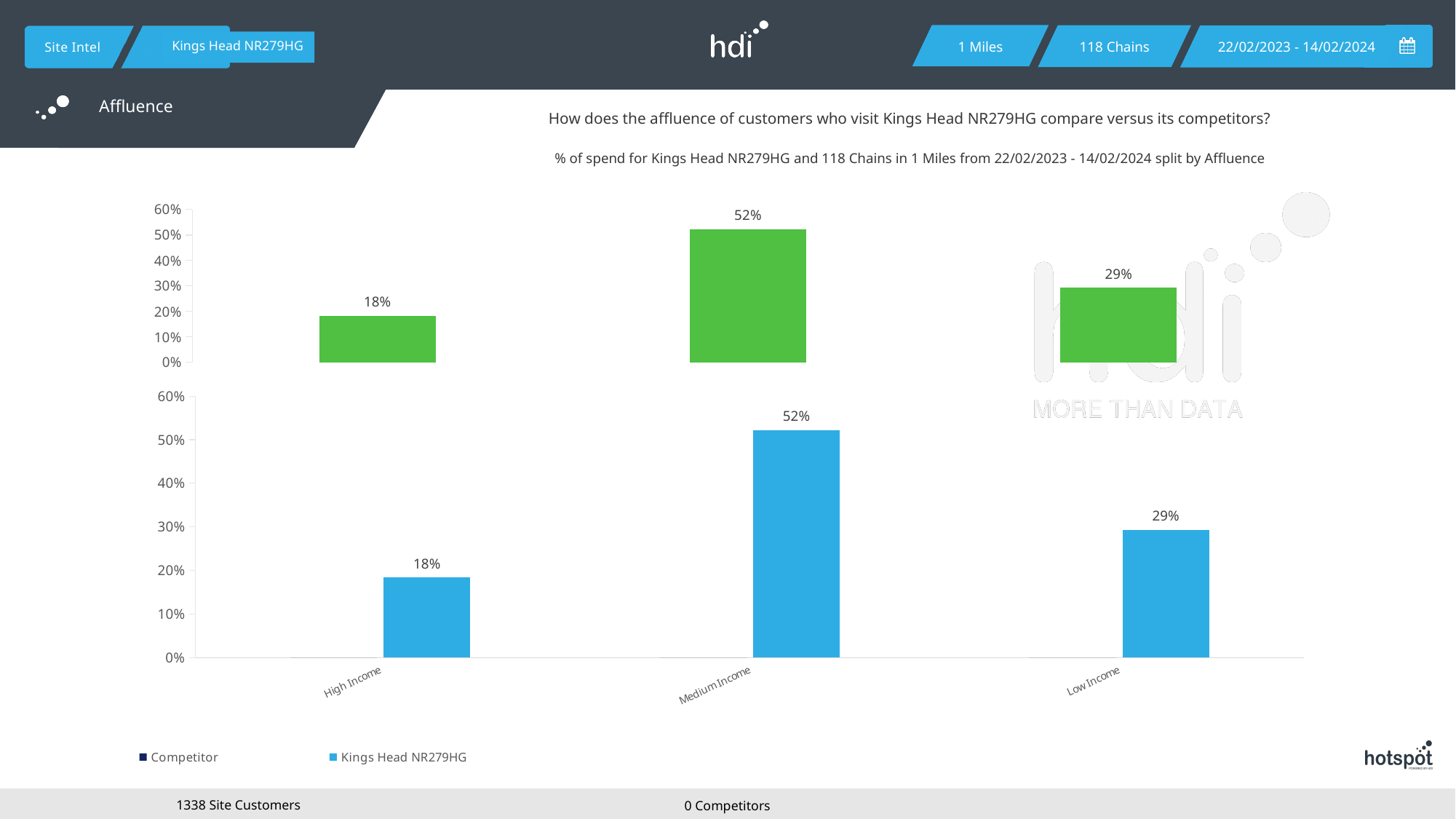
On the bottom chart, which is larger, the value for Low Income or the value for High Income? Low Income On the top chart, what is the value shown on the middle bar? 52% On the bottom chart, what is the value for Low Income? 29% How many categories are shown on the bottom chart? 3 On the bottom chart, which category has the highest value? Medium Income What kind of chart is the bottom chart? Bar chart On the bottom chart, what is the value for High Income? 18% On the top chart, what is the value shown on the right-hand bar? 29% On the bottom chart, which category has the lowest value? High Income How many series does the legend at the bottom of the slide list? 2 On the bottom chart, what is the difference between the values for Medium Income and Low Income? 23% On the bottom chart, what is the value for Medium Income? 52%